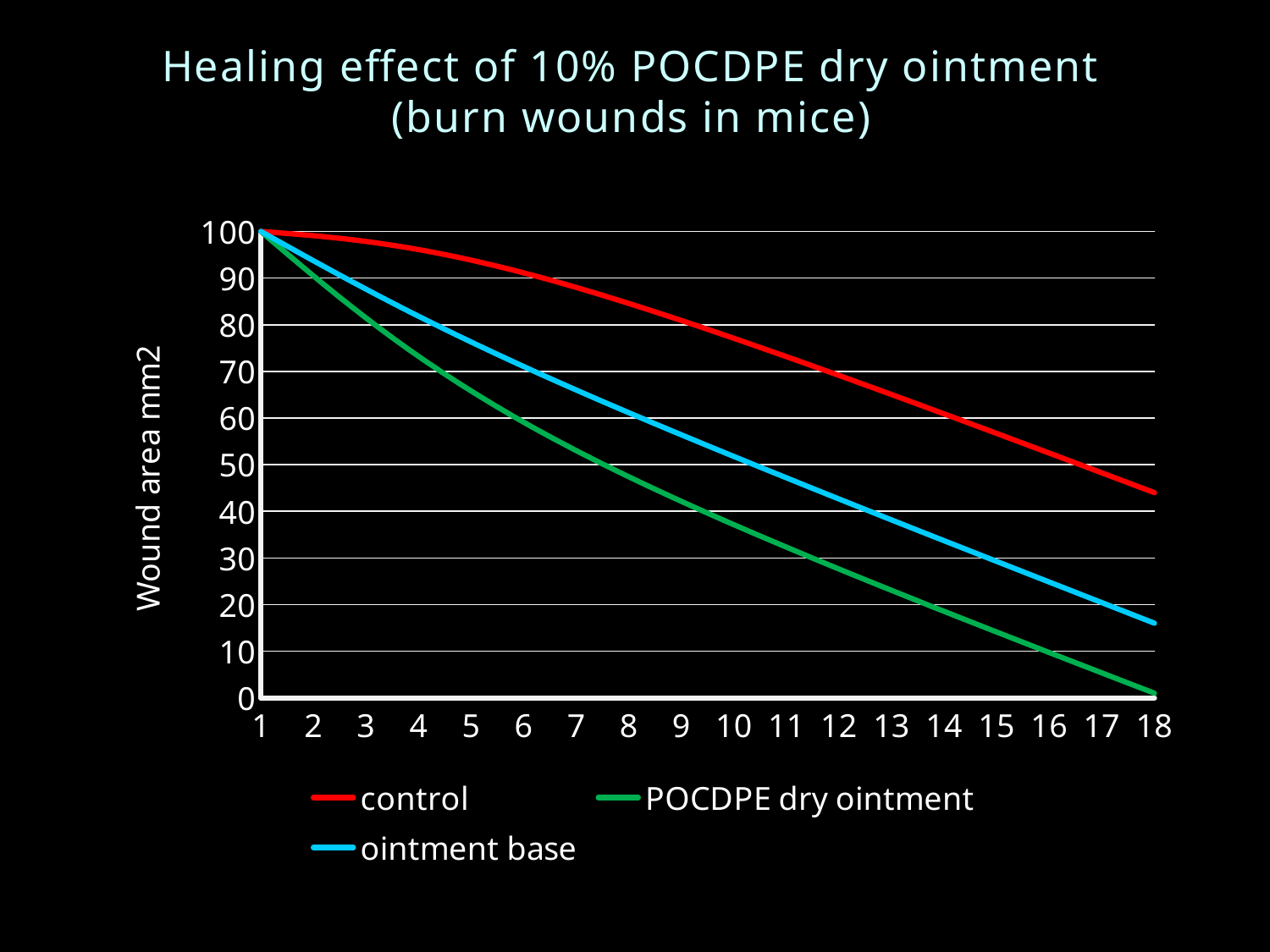
How many series does the legend list? 3 Which series has the highest wound area at x = 18? control Is the value for control at x = 18 greater or less than 40? greater Does the wound area for the control series rise or fall along the x axis? fall What is the label of the y axis? Wound area mm2 Is the value for POCDPE dry ointment at x = 6 greater or less than 70? less How many points are plotted along the x axis for each series? 18 Is the value for ointment base at x = 18 greater or less than 20? less Which series has the lowest wound area at x = 18? POCDPE dry ointment What is the wound area for the POCDPE dry ointment series at x = 1? 100 At x = 12, which series has the larger wound area, control or ointment base? control What kind of chart is shown on the slide? line chart